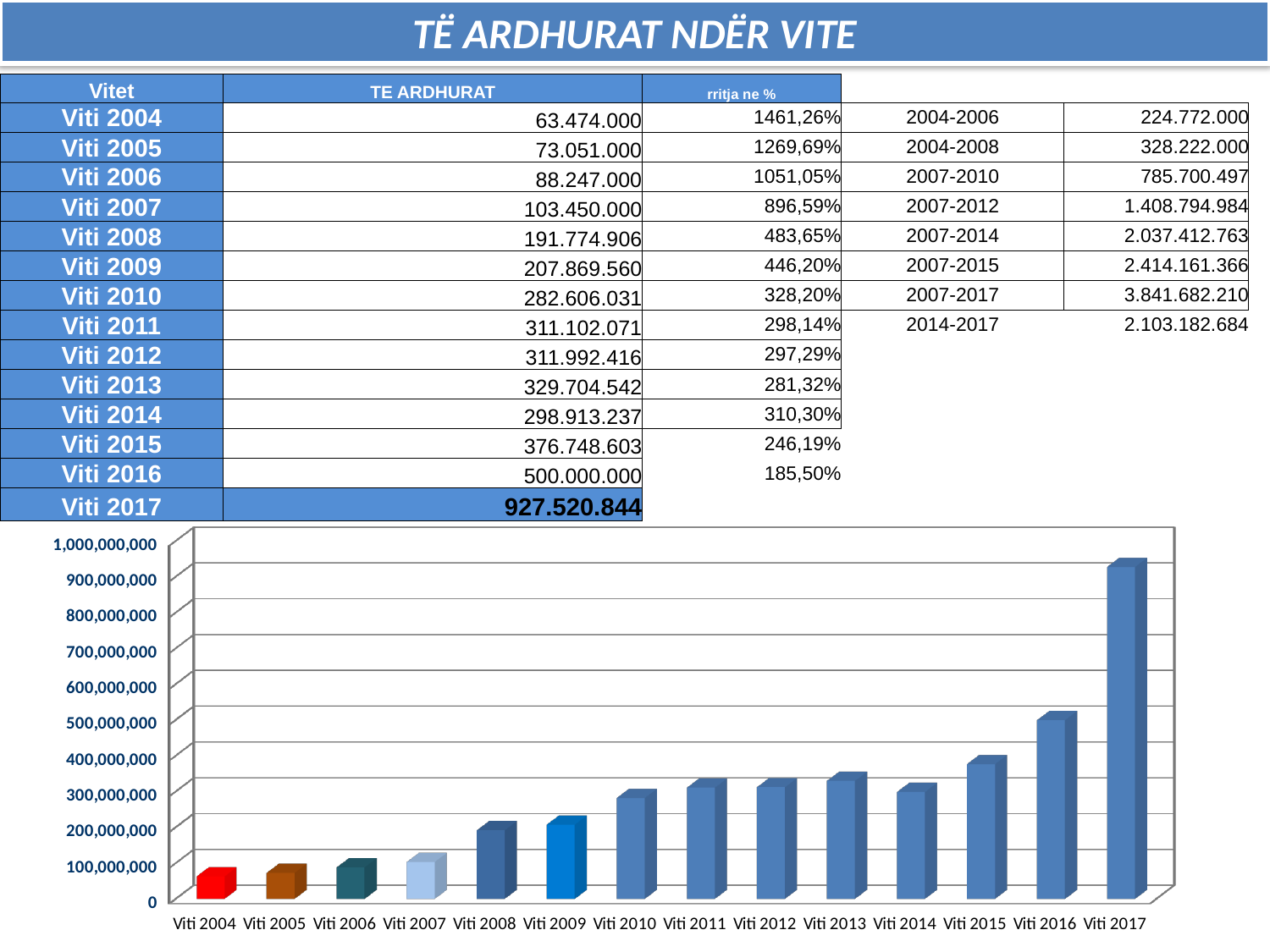
What colour is the bar for Viti 2004 in the chart? red According to the table above the chart, what is the TE ARDHURAT value for Viti 2017? 927.520.844 How many years (categories) are plotted on the x axis of the chart? 14 Is the value for Viti 2009 greater or less than 300,000,000? less Using the table values, what is the difference between Viti 2017 (927.520.844) and Viti 2016 (500.000.000)? 427.520.844 Which year has the tallest bar in the chart? Viti 2017 What kind of chart is shown at the bottom of the slide? bar chart Is the value for Viti 2010 greater or less than 200,000,000? greater Which year has the shortest bar in the chart? Viti 2004 Is the value for Viti 2017 greater or less than 800,000,000? greater Which is larger, the bar for Viti 2015 or the bar for Viti 2014? Viti 2015 Do the values generally rise or fall from Viti 2004 to Viti 2017? rise